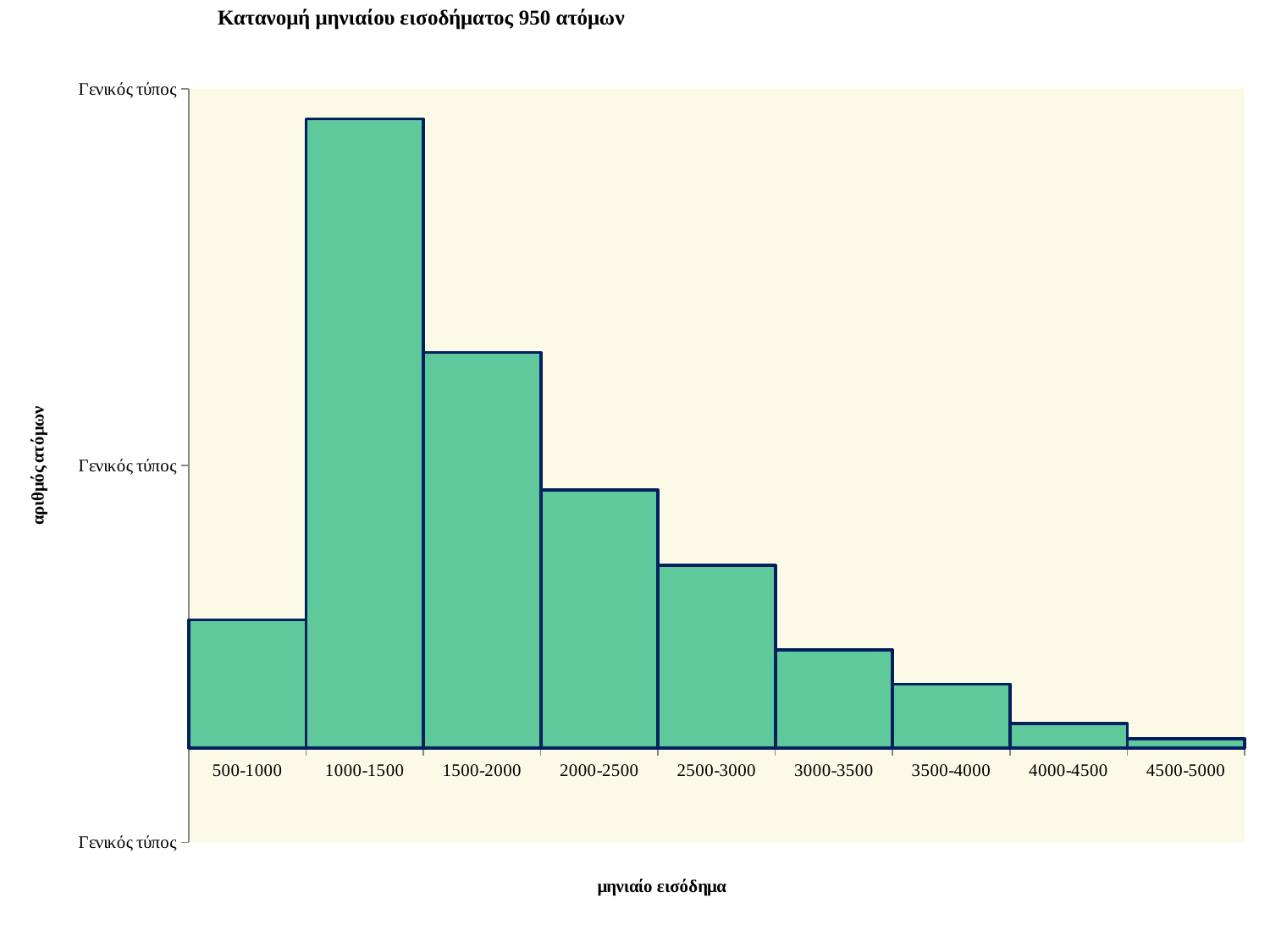
Which income category has the highest number of people? 1000-1500 Which has the larger value, 1500-2000 or 2000-2500? 1500-2000 What is the title of the chart? Κατανομή μηνιαίου εισοδήματος 950 ατόμων Do the values rise or fall along the x axis from 1000-1500 to 4500-5000? Fall Which income category has the lowest number of people? 4500-5000 Which has the larger value, 500-1000 or 3000-3500? 500-1000 Which category has the second highest value? 1500-2000 How many income categories are shown on the x axis? 9 What kind of chart is shown on the slide? Bar chart What is the label of the x axis? μηνιαίο εισόδημα Which has the larger value, 500-1000 or 2500-3000? 2500-3000